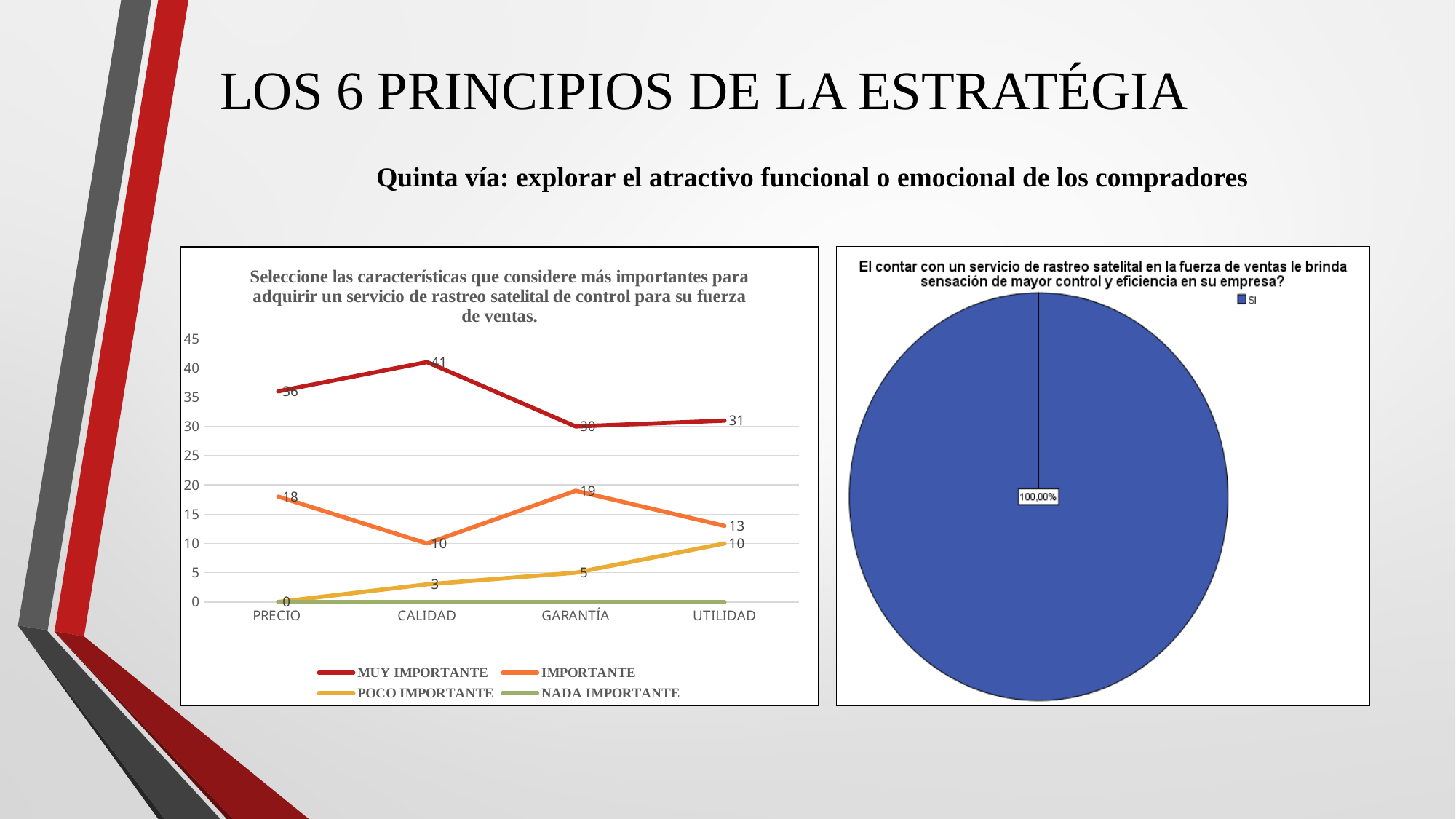
In the left chart, what is the MUY IMPORTANTE value for CALIDAD? 41 In the left chart, which is larger: the IMPORTANTE value for PRECIO or for UTILIDAD? PRECIO In the left chart, what is the difference between the MUY IMPORTANTE values for CALIDAD and GARANTÍA? 11 In the left chart, which category has the lowest IMPORTANTE value? CALIDAD In the right chart, what share of the pie does the SI slice represent? 100,00% In the left chart, what is the IMPORTANTE value for GARANTÍA? 19 What kind of chart is the chart on the right? pie chart In the left chart, how many categories are shown on the x axis? 4 In the left chart, does the POCO IMPORTANTE series rise or fall from PRECIO to UTILIDAD? rise In the left chart, which category has the highest MUY IMPORTANTE value? CALIDAD In the left chart, how many series does the legend list? 4 In the left chart, what is the POCO IMPORTANTE value for UTILIDAD? 10